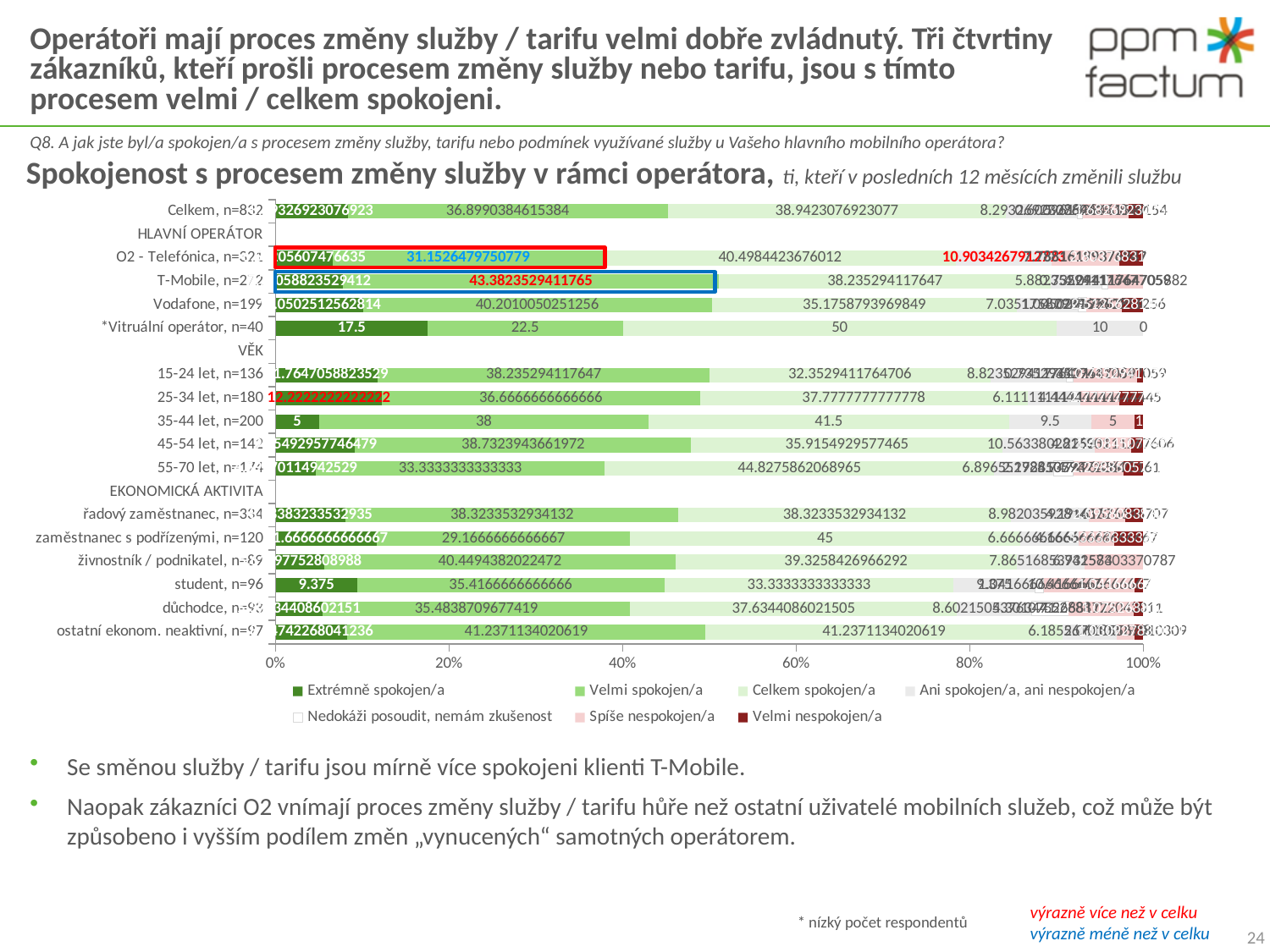
What is the difference between 'Velmi spokojen/a' and 'Extrémně spokojen/a' for '35-44 let, n=200'? 33 What is the value of 'Velmi spokojen/a' for 'T-Mobile'? 43.3823529411765 Which has a larger 'Velmi spokojen/a' value, T-Mobile or O2 - Telefónica? T-Mobile Which category has the highest value of 'Velmi spokojen/a'? T-Mobile Which category has the lowest value of 'Velmi spokojen/a'? *Virtuální operátor, n=40 What is the value of 'Extrémně spokojen/a' for 'student, n=96'? 9.375 Is the value of 'Velmi spokojen/a' for 'zaměstnanec s podřízenými, n=120' greater or less than 40%? less What is the value of 'Extrémně spokojen/a' for '*Virtuální operátor, n=40'? 17.5 How many series does the legend of the chart list? 7 What is the value of 'Celkem spokojen/a' for 'zaměstnanec s podřízenými, n=120'? 45 What is the value of 'Velmi spokojen/a' for '35-44 let, n=200'? 38 What kind of chart is shown on the slide? bar chart